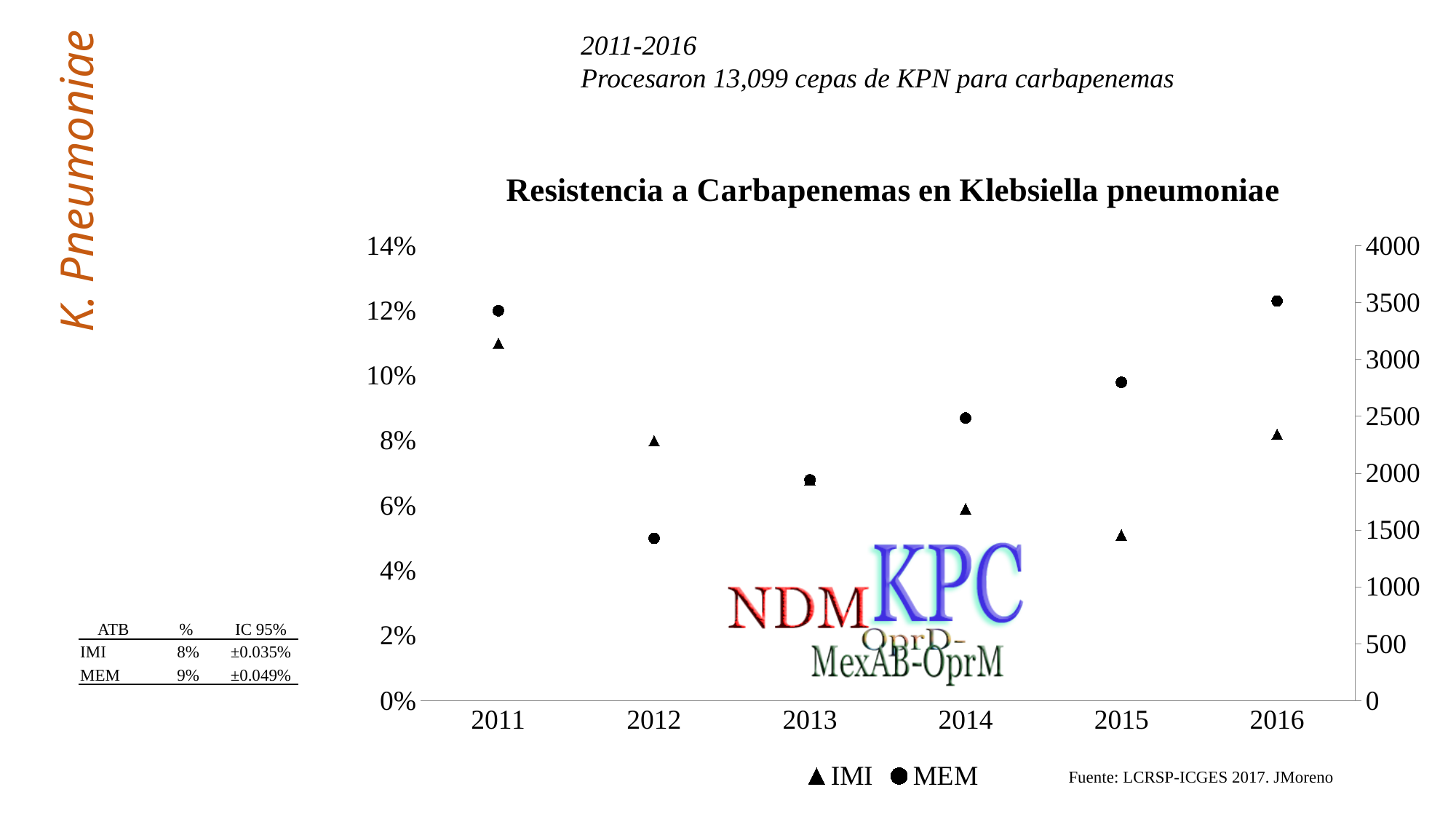
In 2015, which series has the larger value, IMI or MEM? MEM In which year is the IMI value highest? 2011 Do the MEM values rise or fall from 2012 to 2016? rise In which year is the MEM value lowest? 2012 What is the title of the chart? Resistencia a Carbapenemas en Klebsiella pneumoniae In 2012, which series has the larger value, IMI or MEM? IMI How many series does the chart legend list? 2 Is the IMI value for 2011 greater or less than 10%? greater Is the MEM value for 2012 greater or less than 6%? less What kind of chart is shown on the slide? scatter chart How many years are plotted on the x axis of the chart? 6 In which year is the IMI value lowest? 2015